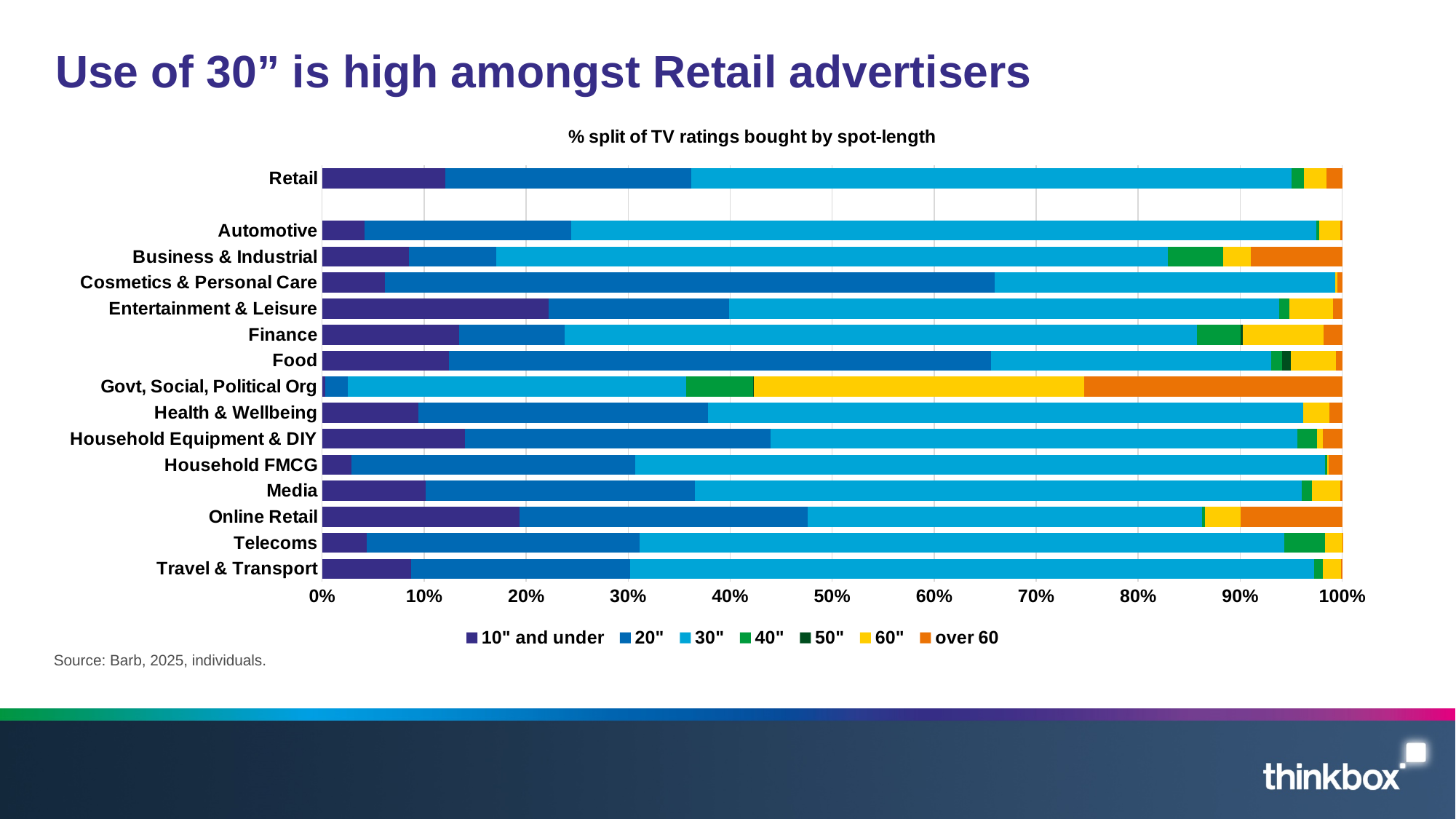
Which category has the largest '60"' segment? Govt, Social, Political Org What is the title of the chart? % split of TV ratings bought by spot-length Which is larger, the '10" and under' share for Retail or for Automotive? Retail What kind of chart is shown on the slide? Stacked bar chart Is the '10" and under' share for Entertainment & Leisure greater or less than 20%? greater Which category has the largest 'over 60' segment? Govt, Social, Political Org Which category has the largest '10" and under' segment? Entertainment & Leisure How many advertiser categories are plotted on the chart? 15 Is the '60"' share for Govt, Social, Political Org greater or less than 30%? greater How many series does the chart legend list? 7 What does each stacked bar total? 100%